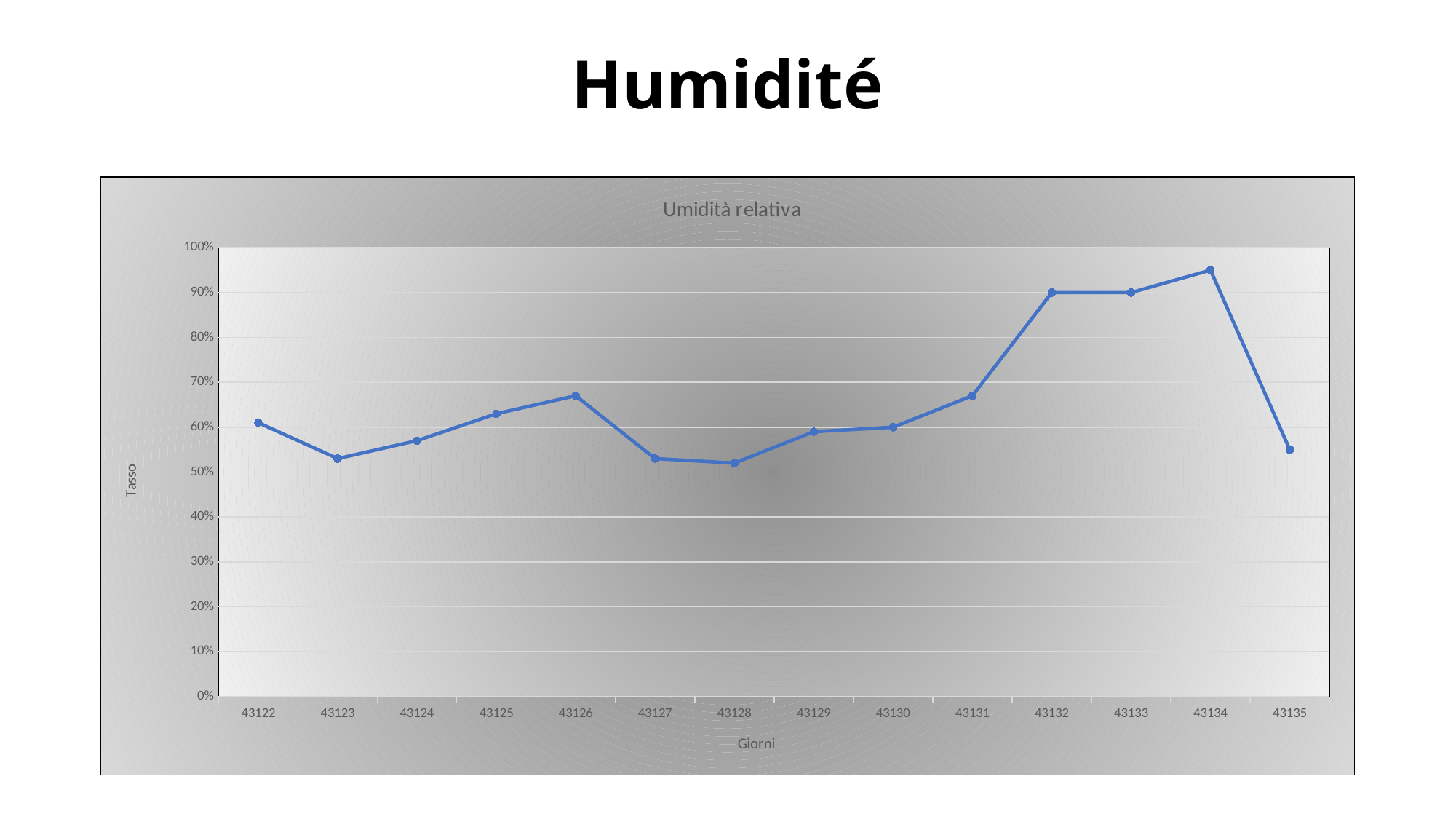
What is the value for day 43132? 90% How many data points are plotted along the x axis? 14 Do the values rise or fall from 43131 to 43134? rise What kind of chart is shown on the slide? line chart Is the value for 43135 greater or less than 60%? less Which day has the highest relative humidity value? 43134 Which is larger, the value for 43126 or the value for 43127? 43126 Is the value for 43128 greater or less than 60%? less What is the title of the chart? Umidità relativa Which is larger, the value for 43134 or the value for 43135? 43134 What is the value for day 43133? 90% Is the value for 43122 greater or less than 50%? greater